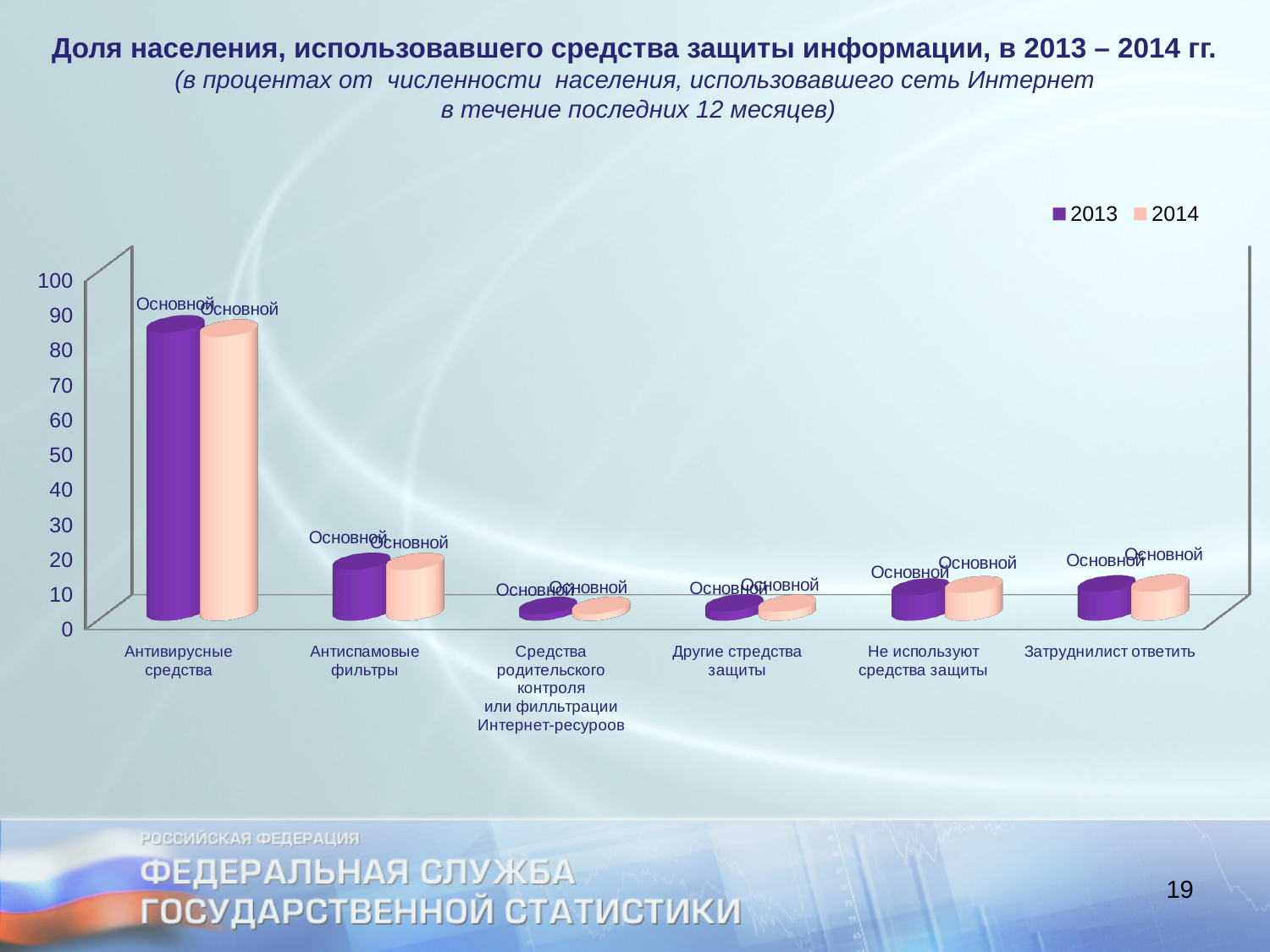
Is the 2013 value for Средства родительского контроля или фильтрации Интернет-ресурсов greater or less than 10? less Which category has the highest value for 2014? Антивирусные средства How many categories are shown on the x axis? 6 How many series does the legend list? 2 What kind of chart is shown on the slide? bar chart Which is larger for 2014: Антиспамовые фильтры or Другие средства защиты? Антиспамовые фильтры Which is larger for 2013: Антивирусные средства or Антиспамовые фильтры? Антивирусные средства Is the 2014 value for Антивирусные средства greater or less than 70? greater Which years are listed in the legend? 2013 and 2014 Is the 2013 value for Антивирусные средства greater or less than 50? greater Which category has the highest value for 2013? Антивирусные средства